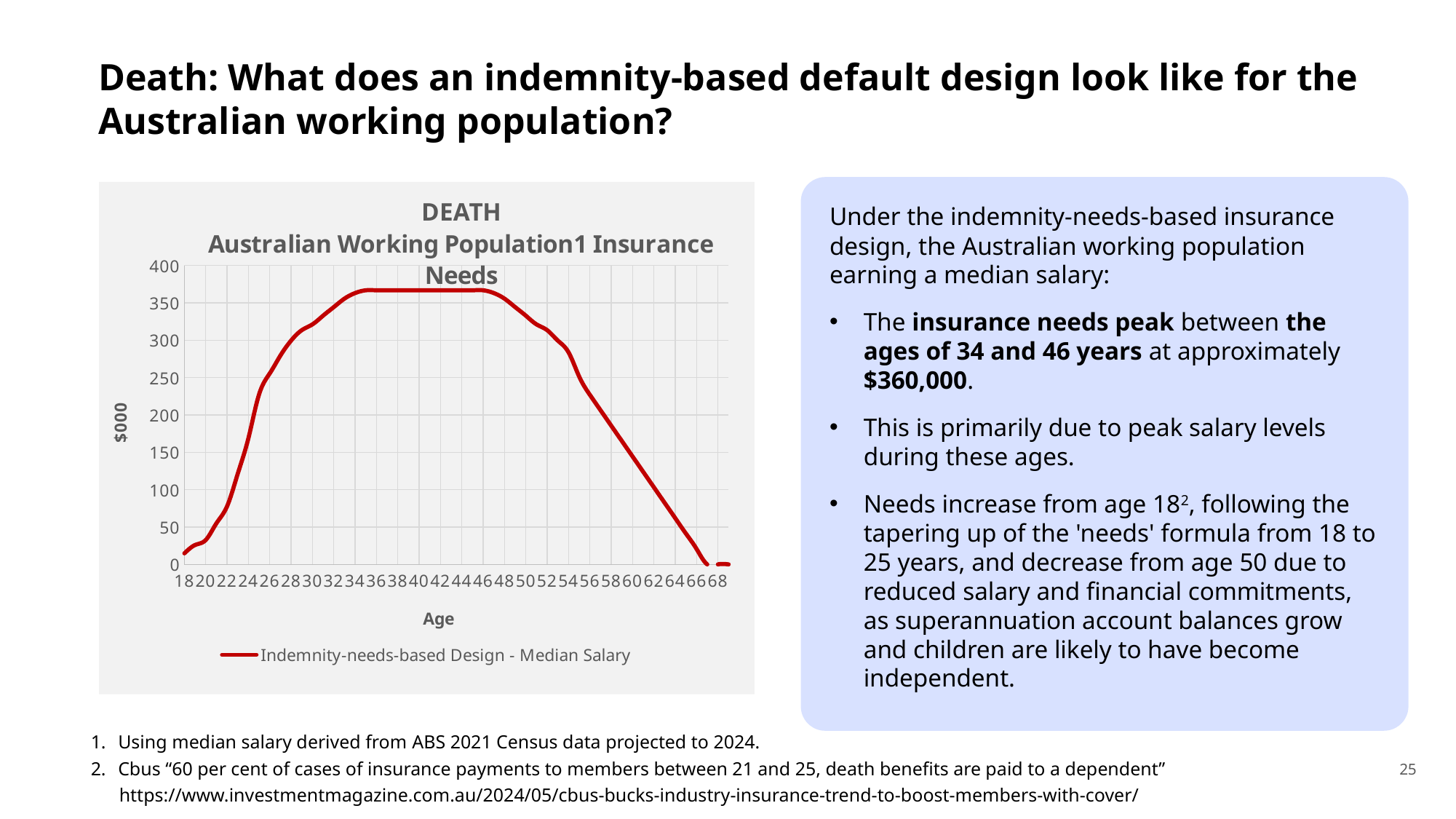
Is the value for age 40 greater or less than 350? greater Do the values rise or fall along the x axis between age 18 and age 34? rise What kind of chart is shown on the slide? line chart Is the value for age 30 greater or less than 300? greater Which is larger, the value at age 18 or the value at age 40? age 40 What is the label on the vertical axis of the chart? $000 Do the values rise or fall along the x axis between age 50 and age 66? fall How many series does the chart legend list? 1 Is the value for age 58 greater or less than 250? less What is the name of the series shown in the chart legend? Indemnity-needs-based Design - Median Salary